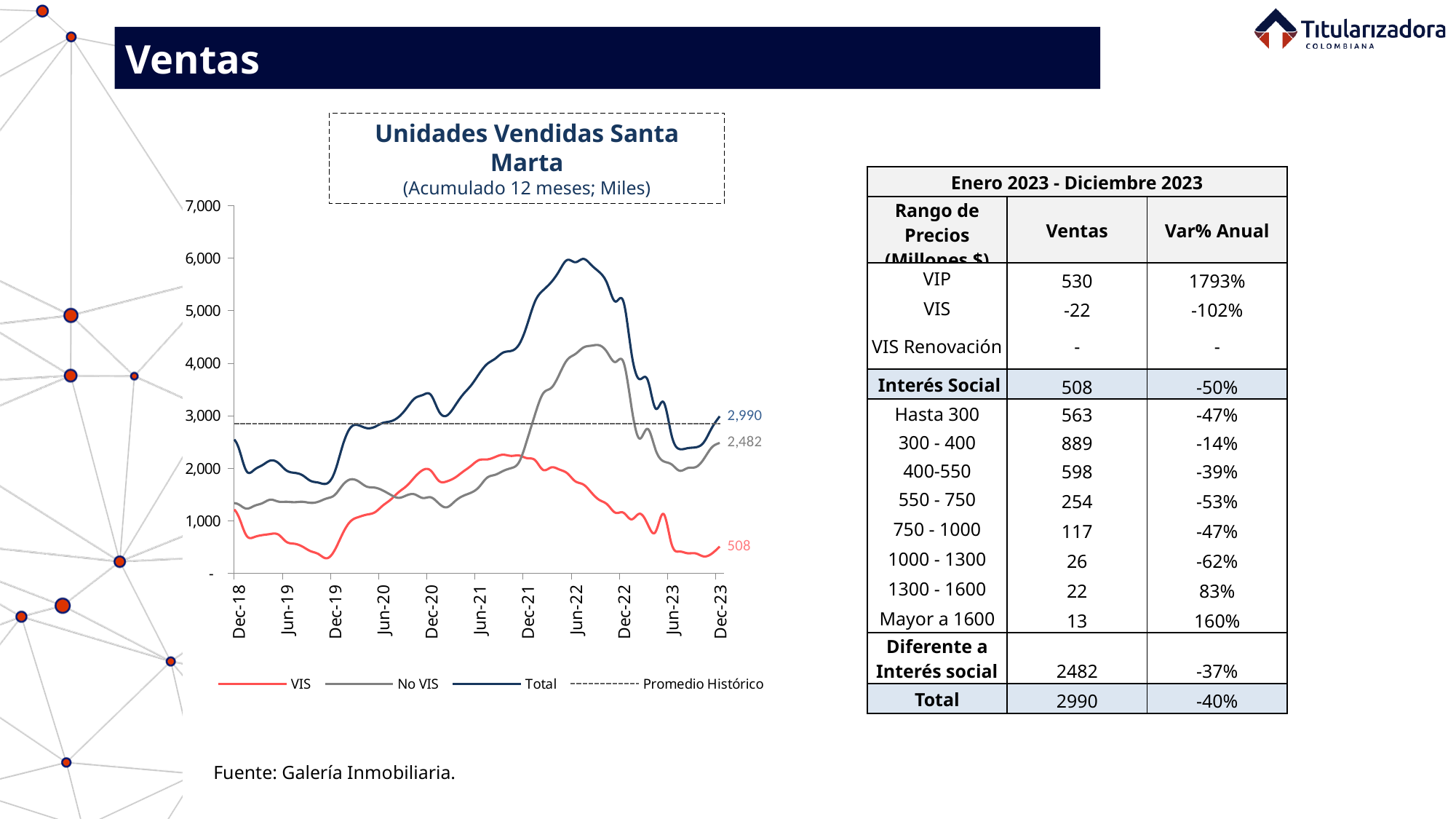
In the 'Unidades Vendidas Santa Marta' chart, does the Total series rise or fall between Jun-22 and Jun-23? Fall In the 'Unidades Vendidas Santa Marta' chart, which series has the highest value at Dec-23? Total In the 'Unidades Vendidas Santa Marta' chart, what is the value of the Total series at Dec-23? 2,990 In the 'Unidades Vendidas Santa Marta' chart, what is the difference between the No VIS and VIS values at Dec-23? 1,974 In the 'Unidades Vendidas Santa Marta' chart, which is larger at Dec-23: VIS or No VIS? No VIS How many series does the legend of the 'Unidades Vendidas Santa Marta' chart list? 4 In the 'Unidades Vendidas Santa Marta' chart, what is the value of the VIS series at Dec-23? 508 How many tick labels are shown on the x axis of the 'Unidades Vendidas Santa Marta' chart? 11 In the 'Unidades Vendidas Santa Marta' chart, what is the value of the No VIS series at Dec-23? 2,482 In the 'Unidades Vendidas Santa Marta' chart, is the peak value of the Total series around Jun-22 greater or less than 5,000? greater What kind of chart is 'Unidades Vendidas Santa Marta'? Line chart In the 'Unidades Vendidas Santa Marta' chart, is the value of the VIS series at Dec-19 greater or less than 1,000? less